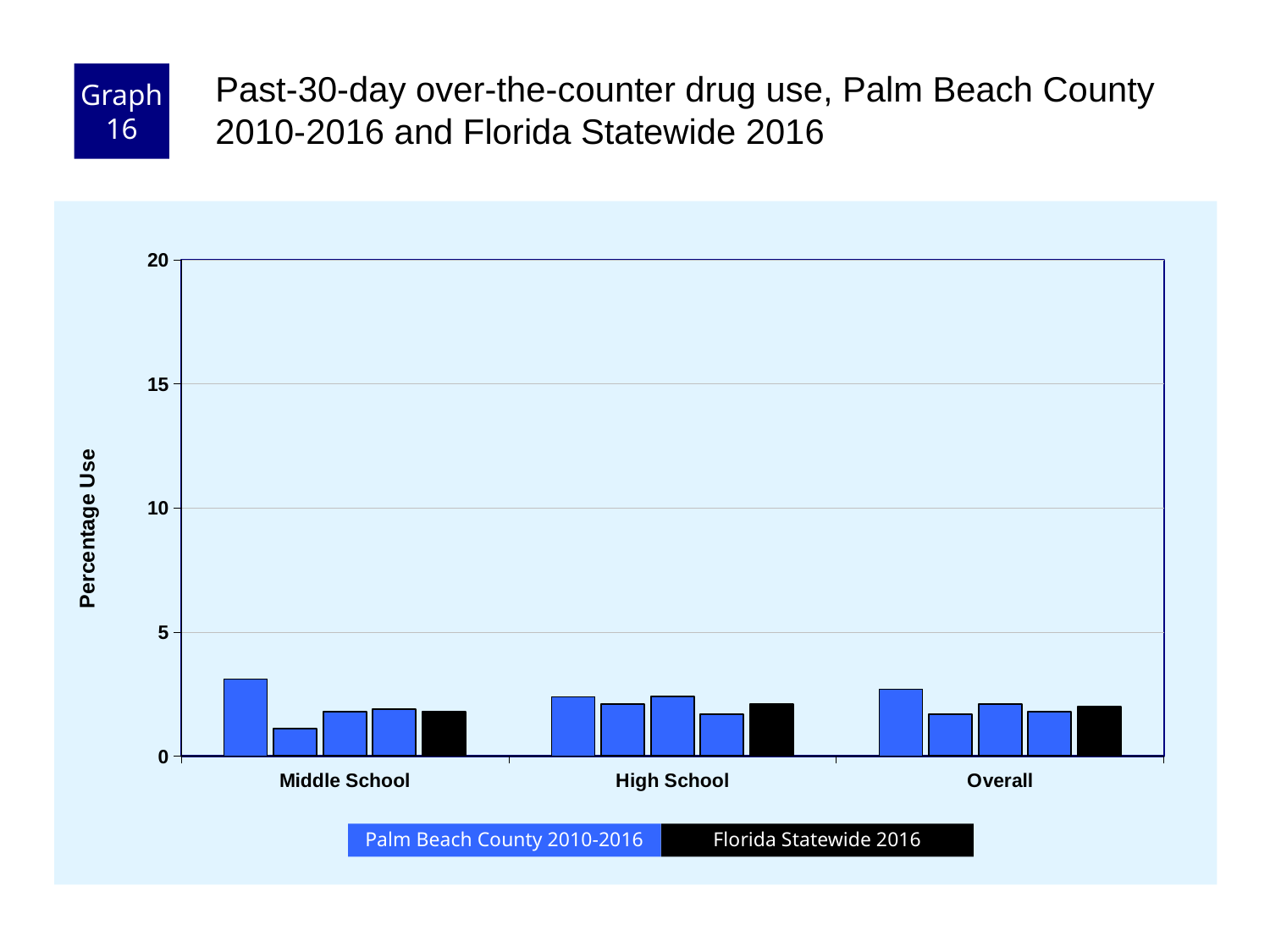
What is the label on the y axis of the chart? Percentage Use Which category group contains the tallest bar in the chart? Middle School In the High School group, which is larger: the fourth Palm Beach County bar or the Florida Statewide 2016 bar? Florida Statewide 2016 How many categories are shown on the x axis of the chart? 3 Is the Florida Statewide 2016 value for Overall greater or less than 5? less How many series does the chart's legend list? 2 In the Middle School group, which is larger: the first (leftmost) Palm Beach County bar or the second Palm Beach County bar? the first (leftmost) bar Which colour represents Florida Statewide 2016 in the chart? black Is the tallest bar in the Middle School group greater or less than 5? less What kind of chart is shown on the slide? bar chart Is the Florida Statewide 2016 value for Middle School greater or less than 10? less